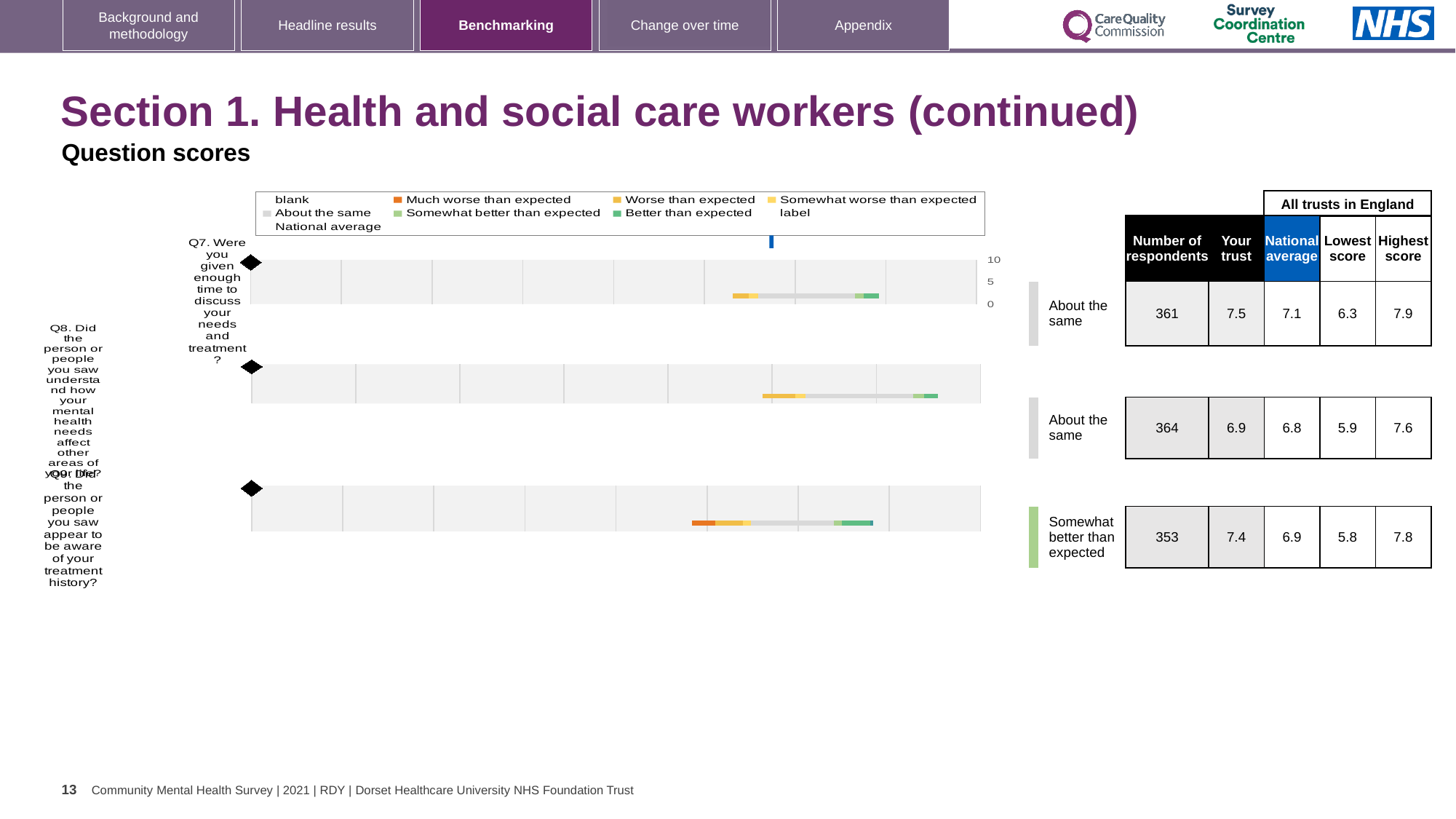
What benchmark category is given for Q9? Somewhat better than expected What is the difference between the highest score and the lowest score for Q9? 2.0 What is the national average score for Q8 (Did the person or people you saw understand how your mental health needs affect other areas of your life?)? 6.8 For Q8, which is larger: the 'Your trust' score or the national average? Your trust What kind of chart is used to show the question scores? Bar chart Which question has the lowest 'Lowest score' value across all trusts in England? Q9 What is the difference between the 'Your trust' score and the national average for Q7? 0.4 How many questions are shown on this slide? 3 What is the highest score across all trusts in England for Q7? 7.9 What is the 'Your trust' score for Q7 (Were you given enough time to discuss your needs and treatment?)? 7.5 Which question has the highest 'Your trust' score on this slide? Q7 How many respondents answered Q9 (Did the person or people you saw appear to be aware of your treatment history?)? 353